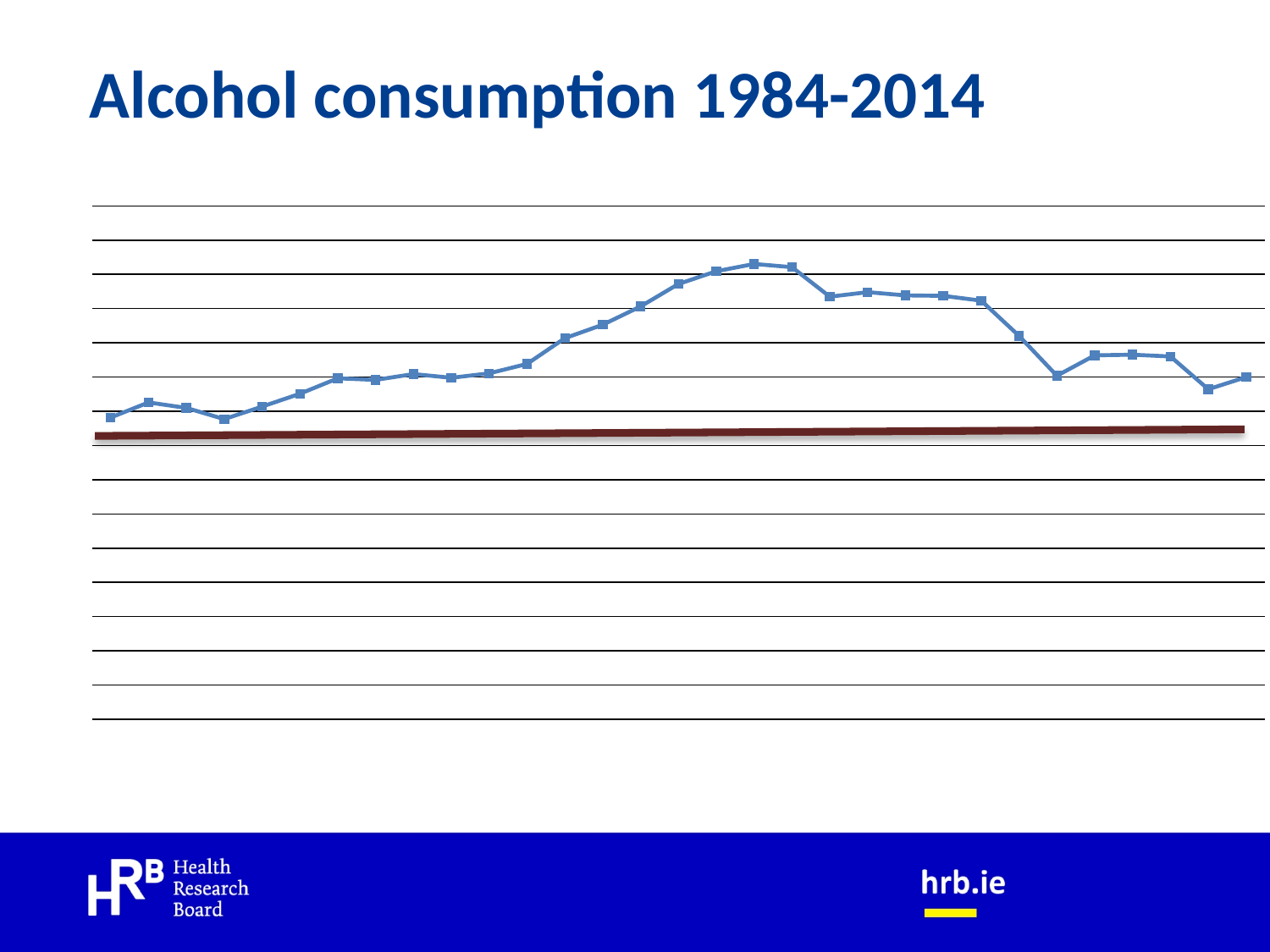
Is the highest point of the blue line near the start, near the middle, or near the end of the chart? near the middle How many data points (markers) are on the blue line? 31 What kind of chart is shown on the slide? line chart Is the lowest point of the blue line near the start, near the middle, or near the end of the chart? near the start What is the title of the chart on the slide? Alcohol consumption 1984-2014 How many lines are plotted on the chart? 1 Is the last point of the blue line higher or lower than its first point? higher Does the blue line rise or fall over the first half of the chart? rise Does the blue line rise, fall, or rise then fall across the chart from left to right? rise then fall What colour is the line with the square markers? blue